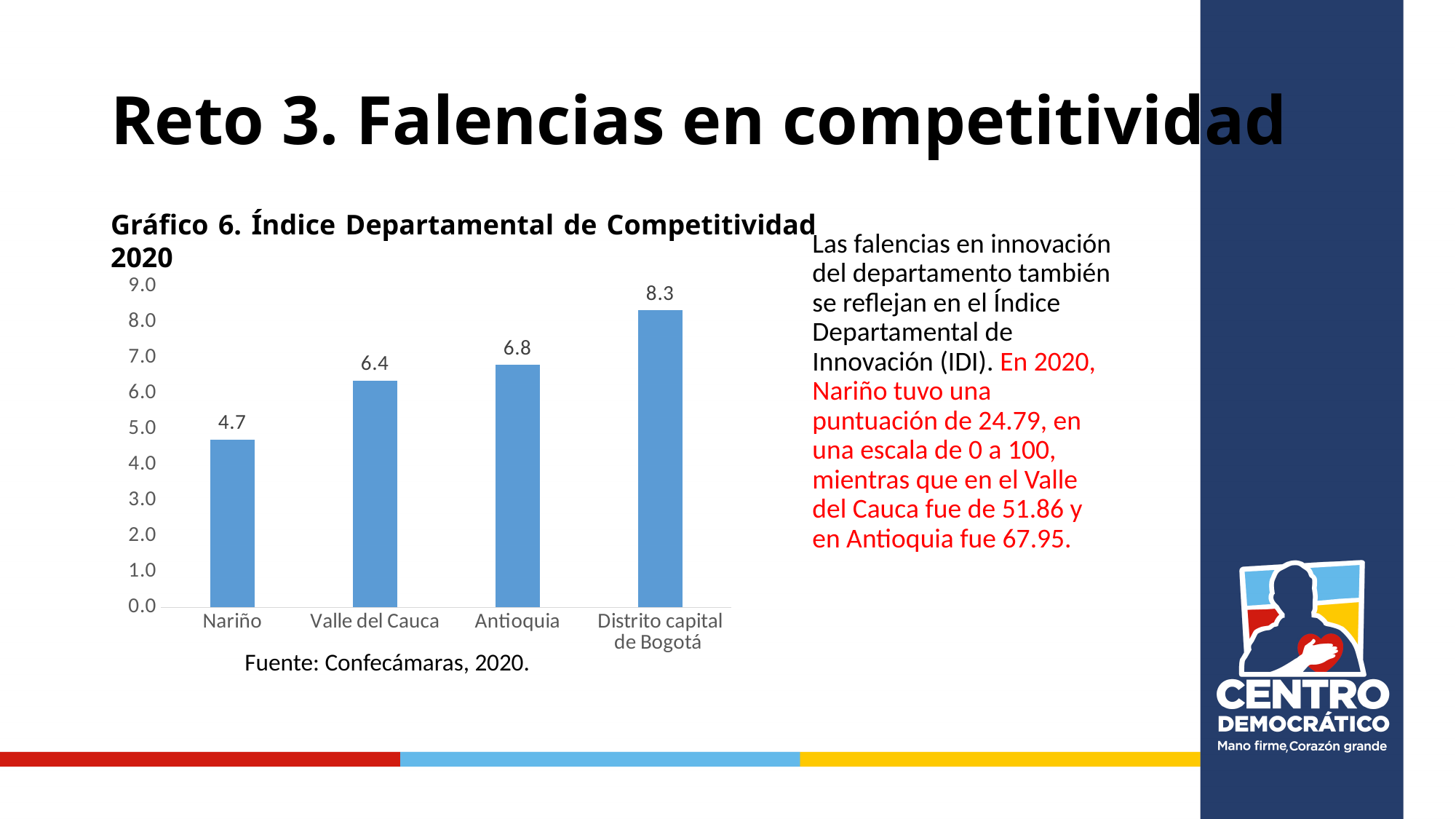
Which is larger, the value for Antioquia or the value for Valle del Cauca? Antioquia What kind of chart is shown on the slide? bar chart What is the value for Nariño in the chart? 4.7 What is the value for Distrito capital de Bogotá in the chart? 8.3 Which category has the lowest value in the chart? Nariño What is the title of the chart? Gráfico 6. Índice Departamental de Competitividad 2020 What is the difference between the values for Distrito capital de Bogotá and Nariño? 3.6 Is the value for Nariño greater or less than 5.0? less Which category has the highest value in the chart? Distrito capital de Bogotá How many categories are shown in the chart? 4 What is the value for Antioquia in the chart? 6.8 What is the value for Valle del Cauca in the chart? 6.4